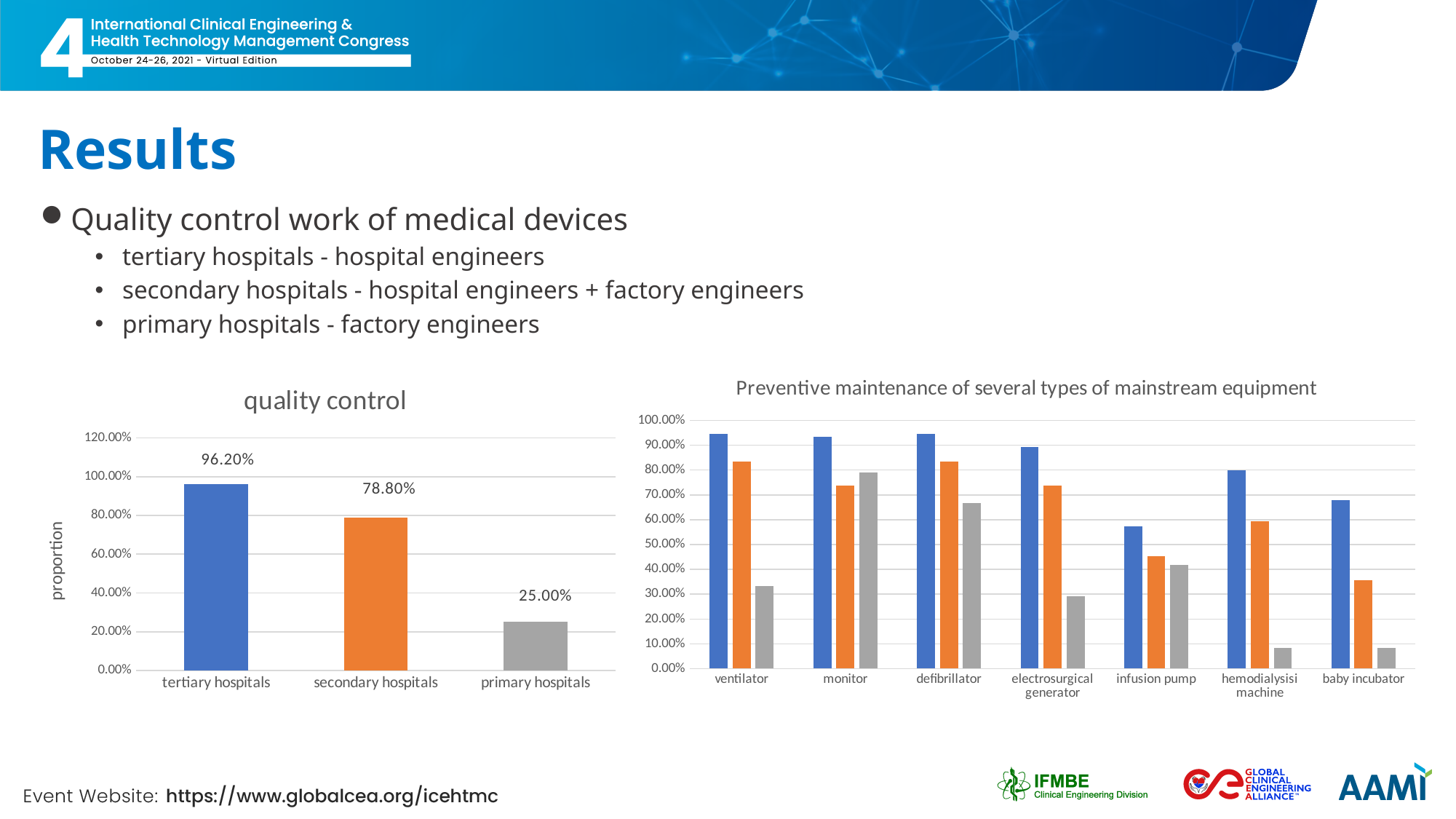
In the "quality control" chart, what is the value for primary hospitals? 25.00% In the "Preventive maintenance of several types of mainstream equipment" chart, is the blue bar for infusion pump greater or less than 50.00%? greater What type of chart is the "quality control" chart? bar chart In the "quality control" chart, which category has the lowest value? primary hospitals In the "Preventive maintenance of several types of mainstream equipment" chart, which is larger for baby incubator: the blue bar or the orange bar? the blue bar In the "quality control" chart, how many categories are shown on the x axis? 3 In the "Preventive maintenance of several types of mainstream equipment" chart, is the grey bar for ventilator greater or less than 40.00%? less In the "Preventive maintenance of several types of mainstream equipment" chart, how many equipment categories are shown on the x axis? 7 In the "quality control" chart, what is the value for secondary hospitals? 78.80% In the "quality control" chart, what is the value for tertiary hospitals? 96.20% In the "quality control" chart, what is the difference between the values for tertiary hospitals and secondary hospitals? 17.40% In the "quality control" chart, which category has the highest value? tertiary hospitals